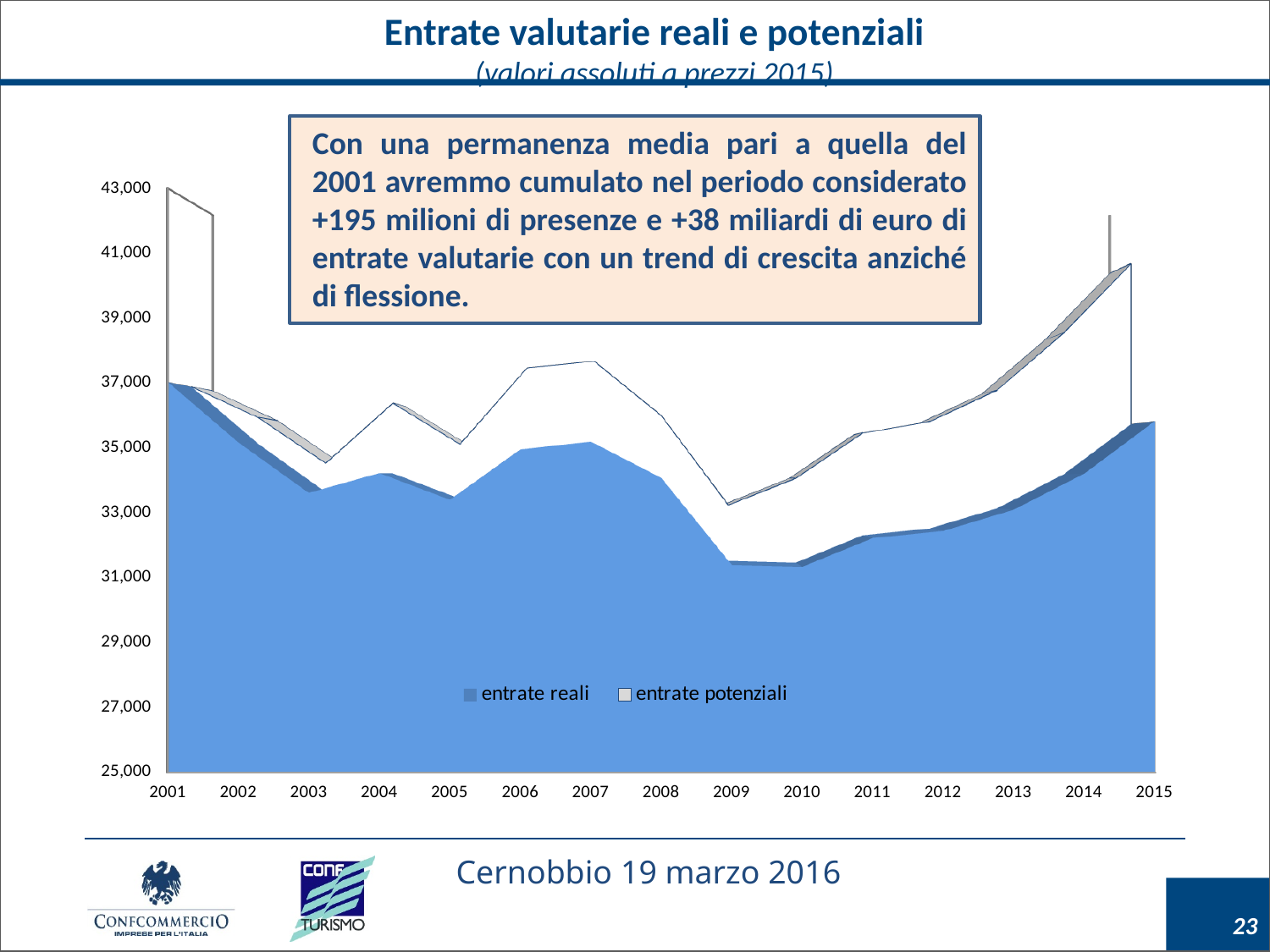
Is the value for entrate reali in 2015 greater or less than 35,000? greater In 2015, which series has the larger value, entrate reali or entrate potenziali? entrate potenziali What are the two series named in the legend? entrate reali and entrate potenziali Is the value for entrate potenziali in 2007 greater or less than 37,000? greater Do the values for entrate reali rise or fall from 2009 to 2015? rise Is the value for entrate reali in 2009 greater or less than 33,000? less What is the title of the chart? Entrate valutarie reali e potenziali In which year does entrate potenziali reach its highest value? 2015 How many years are shown on the x axis? 15 What kind of chart is shown on the slide? Area chart How many series does the legend list? 2